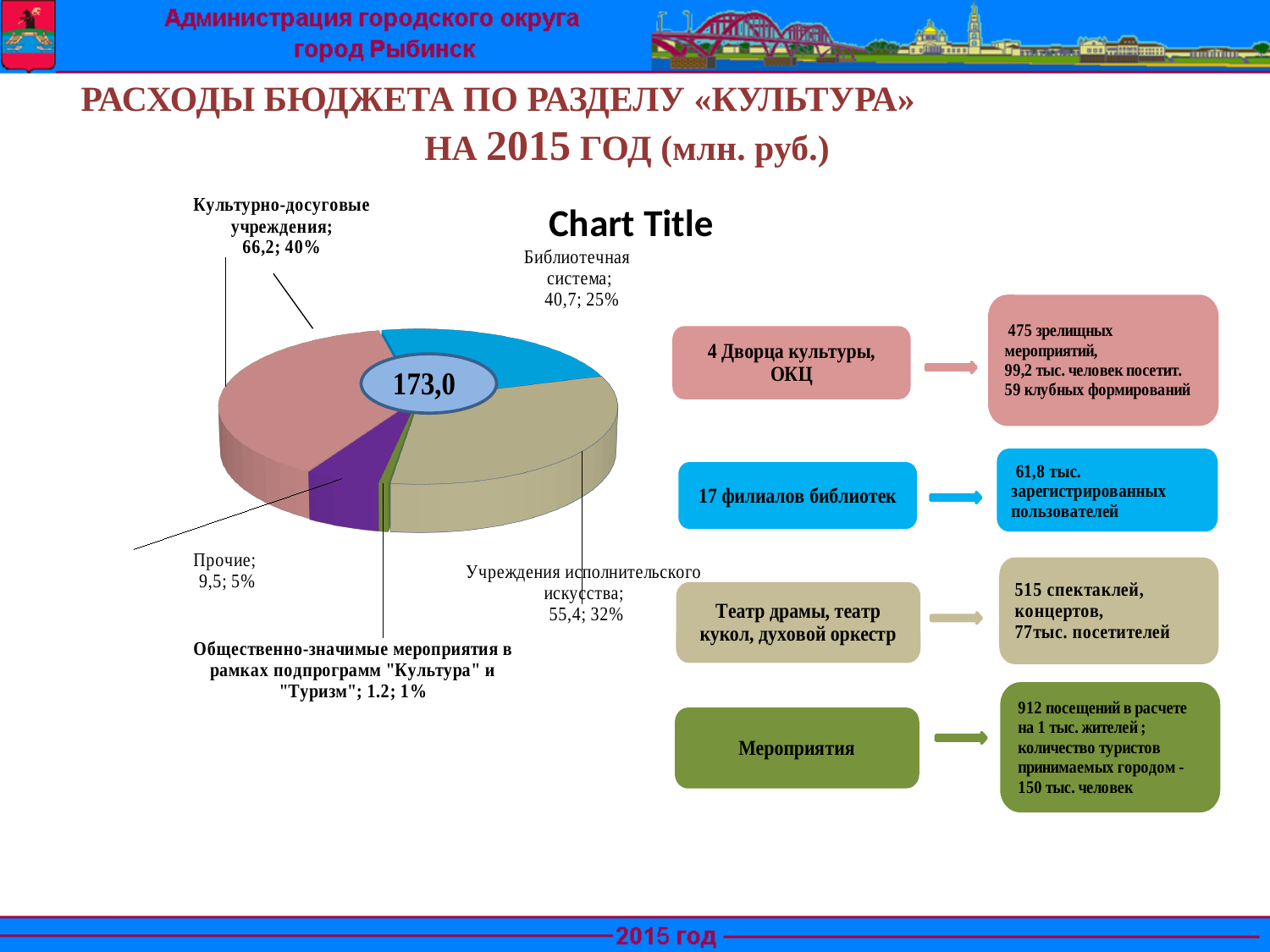
What share of the pie does Прочие represent? 5% Which is larger: the value for Библиотечная система or the value for Прочие? Библиотечная система What is the value for Культурно-досуговые учреждения in the pie chart? 66,2 What is the value for Учреждения исполнительского искусства? 55,4 What share of the pie does Библиотечная система represent? 25% Which category has the smallest slice of the pie? Общественно-значимые мероприятия в рамках подпрограмм "Культура" и "Туризм" How many slices does the pie chart have? 5 What kind of chart is shown on the slide? pie chart What is the title printed above the pie chart? Chart Title Which category has the largest slice of the pie? Культурно-досуговые учреждения What number is shown in the centre of the pie chart? 173,0 What is the difference between the values for Культурно-досуговые учреждения and Учреждения исполнительского искусства? 10,8